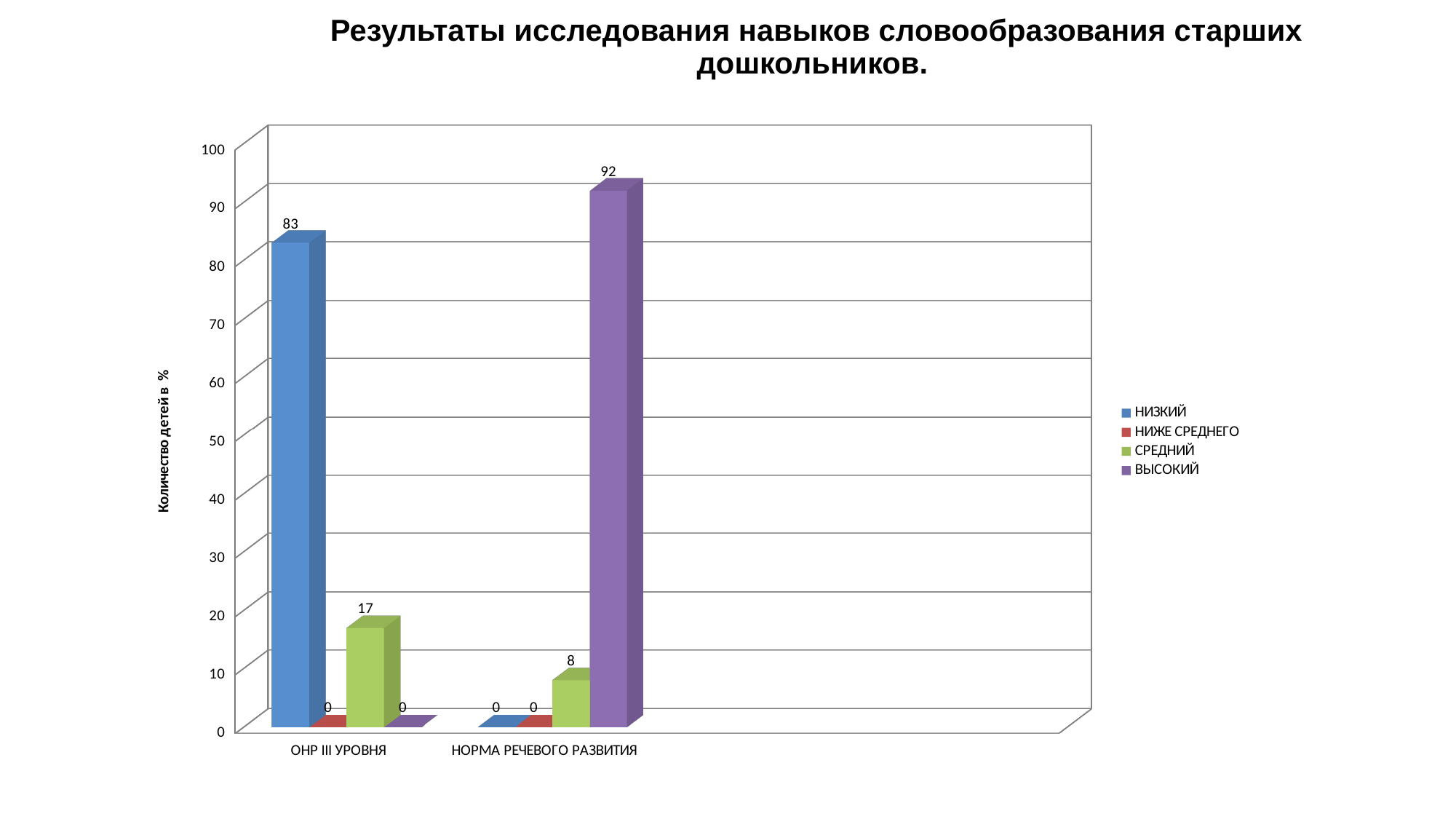
What kind of chart is shown on the slide? Bar chart What is the value for ВЫСОКИЙ in the ОНР III УРОВНЯ category? 0 Which series has the highest value in the ОНР III УРОВНЯ category? НИЗКИЙ What is the difference between the СРЕДНИЙ values for ОНР III УРОВНЯ and НОРМА РЕЧЕВОГО РАЗВИТИЯ? 9 What is the value for НИЗКИЙ in the ОНР III УРОВНЯ category? 83 What is the value for СРЕДНИЙ in the НОРМА РЕЧЕВОГО РАЗВИТИЯ category? 8 How many series does the legend list? 4 What is the value for СРЕДНИЙ in the ОНР III УРОВНЯ category? 17 Which is larger: НИЗКИЙ for ОНР III УРОВНЯ or ВЫСОКИЙ for НОРМА РЕЧЕВОГО РАЗВИТИЯ? ВЫСОКИЙ for НОРМА РЕЧЕВОГО РАЗВИТИЯ What is the value for ВЫСОКИЙ in the НОРМА РЕЧЕВОГО РАЗВИТИЯ category? 92 How many categories are shown on the x axis? 2 Which series has the highest value in the НОРМА РЕЧЕВОГО РАЗВИТИЯ category? ВЫСОКИЙ